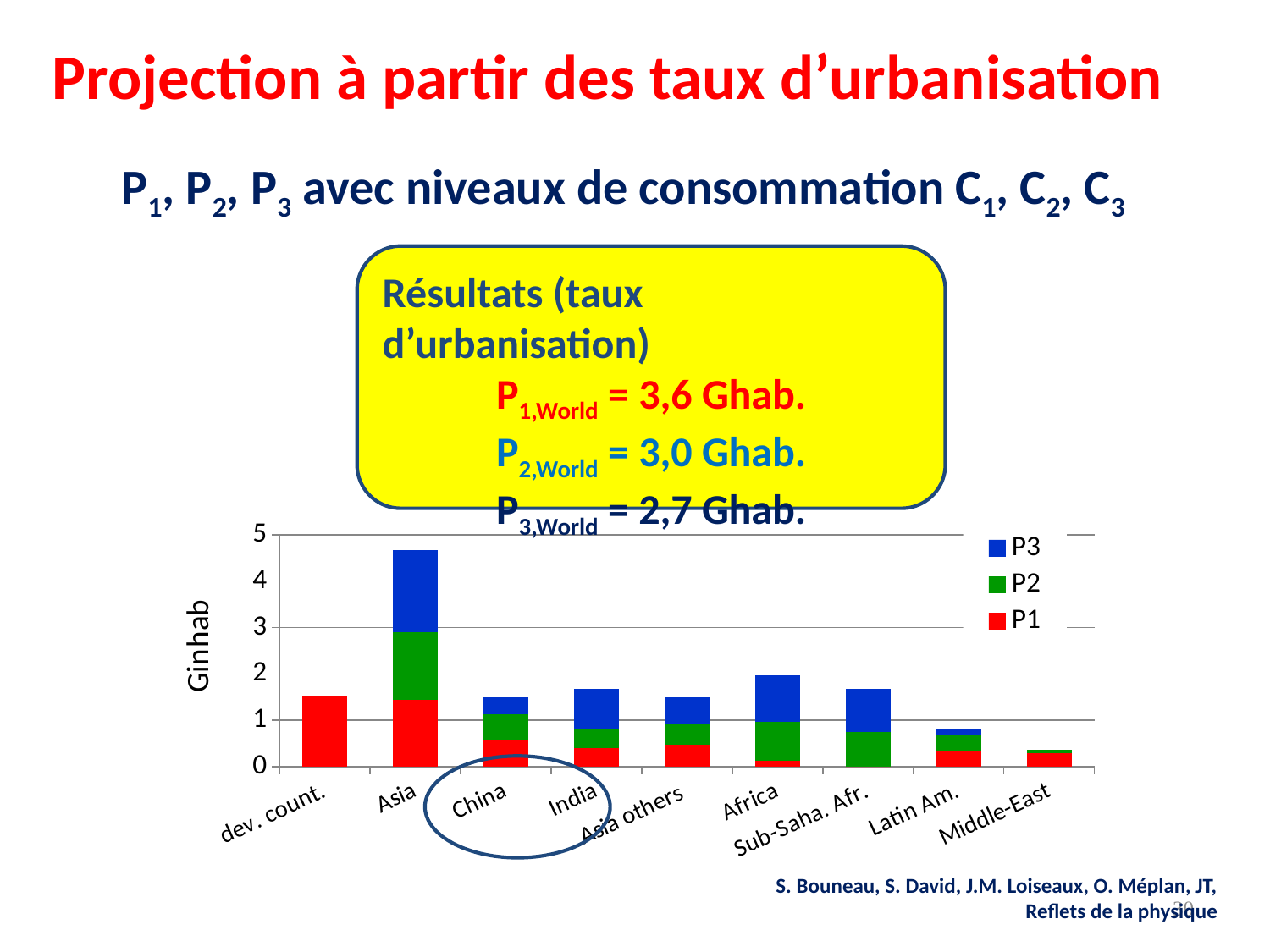
Is the total stacked value for Asia greater or less than 4? greater Is the value for dev. count. greater or less than 1? greater Which category has the tallest stacked bar? Asia How many categories are shown along the x axis of the chart? 9 Which category has the shortest stacked bar? Middle-East Which has a taller stacked bar, Asia or Africa? Asia What is the label on the y axis of the chart? Ginhab Is the total stacked value for Middle-East greater or less than 1? less How many series does the chart's legend list? 3 What kind of chart is shown on the slide? stacked bar chart Which series is shown in red in the chart's legend? P1